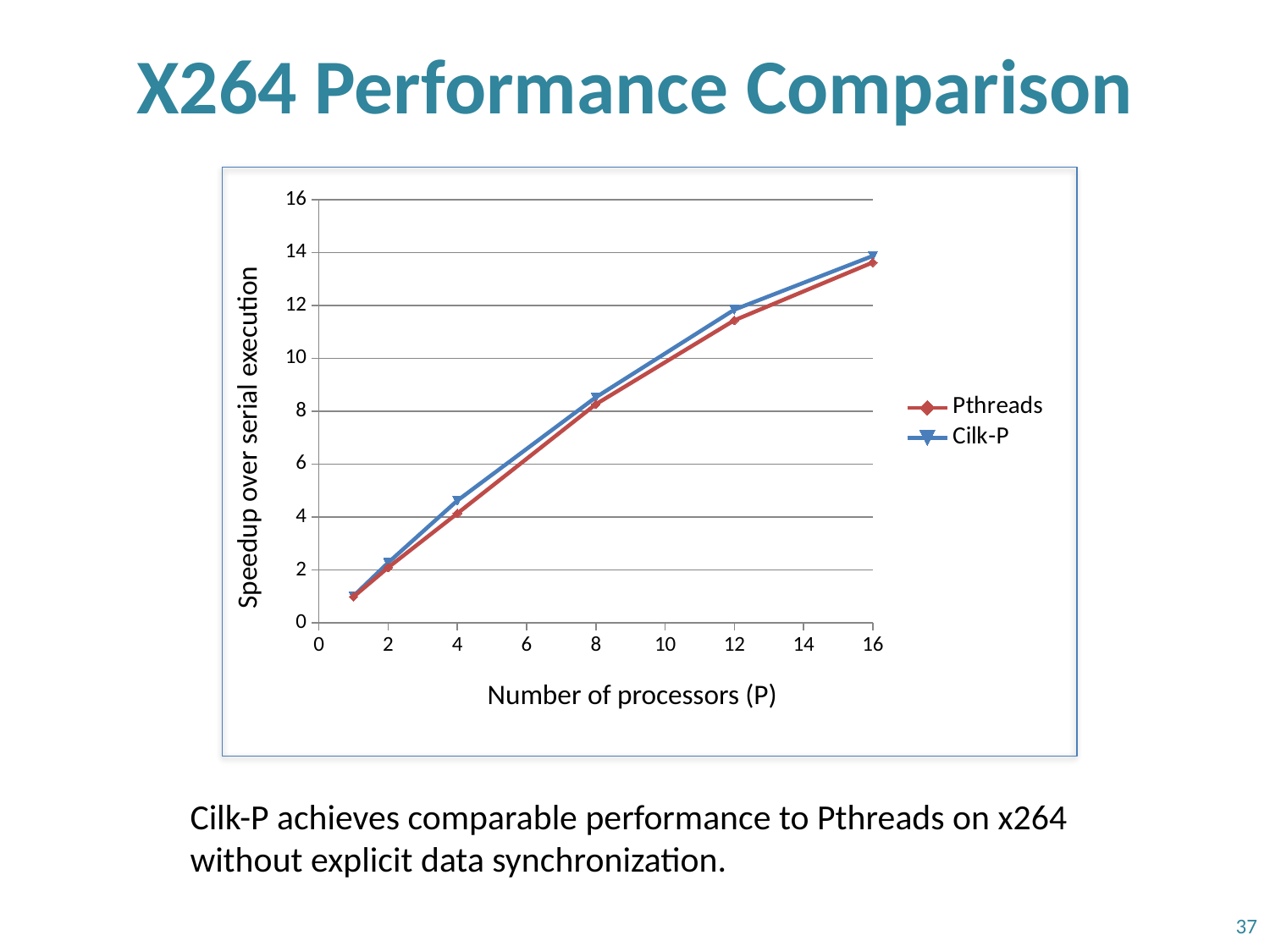
How many series does the legend list? 2 What is the label of the y axis? Speedup over serial execution How many data points are plotted for the Cilk-P series? 6 At 4 processors, which series has the higher speedup, Pthreads or Cilk-P? Cilk-P Which two series are listed in the legend? Pthreads and Cilk-P Is the Cilk-P speedup at 2 processors greater or less than 4? less Is the Pthreads speedup at 8 processors greater or less than 6? greater Do the speedup values rise or fall as the number of processors increases? rise At which number of processors does Cilk-P reach its highest speedup? 16 Is the Cilk-P speedup at 16 processors greater or less than 12? greater At which number of processors is the Pthreads speedup lowest? 1 What kind of chart is shown on the slide? line chart